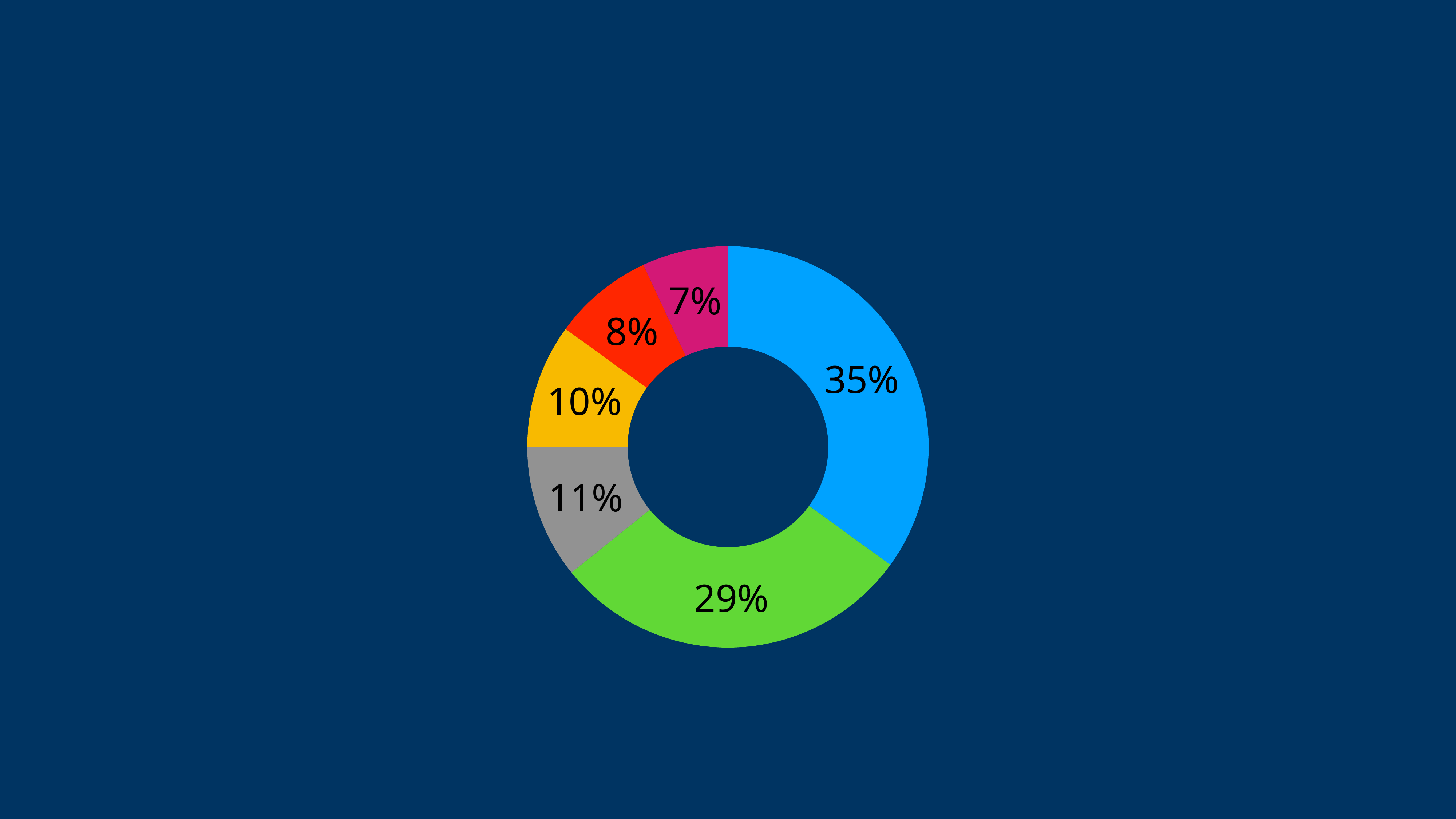
What is the difference between the blue slice and the green slice? 6% How many slices does the doughnut chart have? 6 What percentage is shown on the grey slice? 11% What kind of chart is shown on the slide? Doughnut chart Which is larger, the grey slice or the yellow slice? The grey slice What percentage is shown on the blue slice? 35% What percentage is shown on the red slice? 8% Which slice has the smallest share? The magenta slice (7%) Which slice has the largest share? The blue slice (35%) What percentage is shown on the green slice? 29% What percentage is shown on the magenta slice? 7% What percentage is shown on the yellow slice? 10%